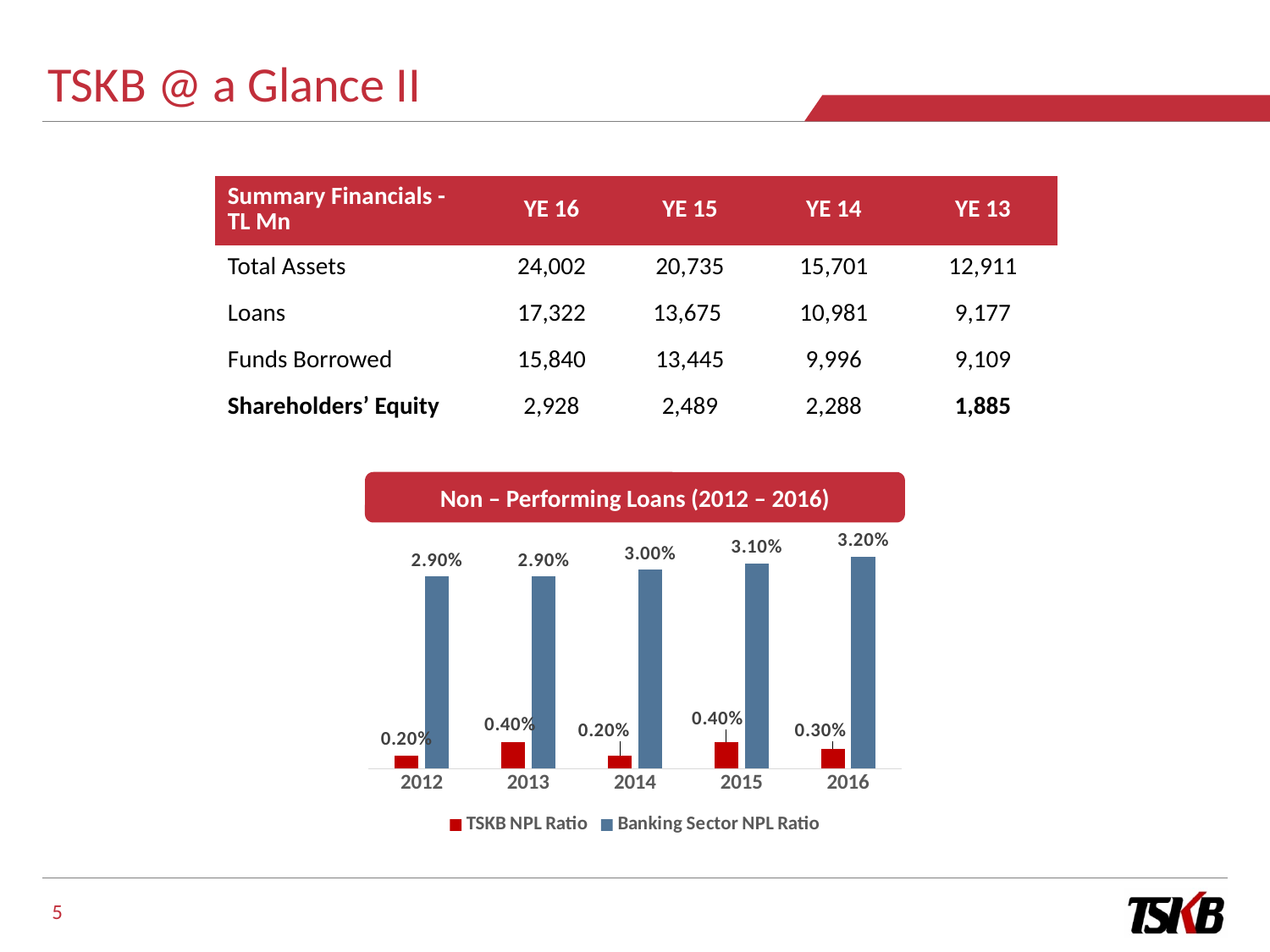
In which year is the Banking Sector NPL Ratio highest? 2016 Does the Banking Sector NPL Ratio rise or fall from 2013 to 2016? Rise What is the difference between the Banking Sector NPL Ratio and the TSKB NPL Ratio in 2015? 2.70% How many series does the chart legend list? 2 How many years are shown on the x axis of the chart? 5 What is the Banking Sector NPL Ratio for 2016? 3.20% What is the lowest TSKB NPL Ratio shown in the chart? 0.20% Which is larger in 2014, the TSKB NPL Ratio or the Banking Sector NPL Ratio? Banking Sector NPL Ratio What type of chart is used to show the non-performing loans data? Bar chart What is the Banking Sector NPL Ratio for 2014? 3.00% What is the TSKB NPL Ratio for 2013? 0.40% What is the TSKB NPL Ratio for 2016? 0.30%